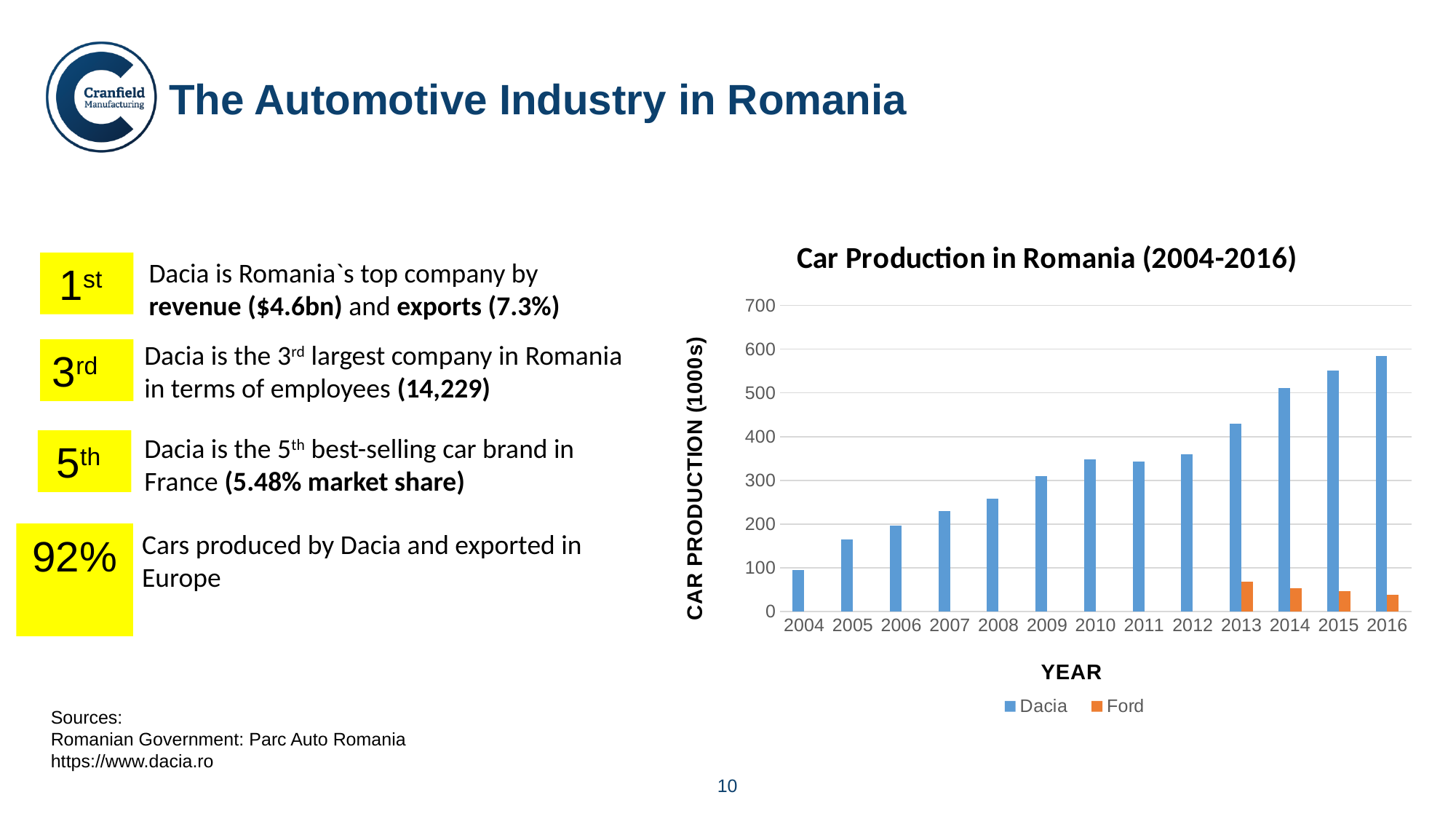
In which year is Ford's car production highest? 2013 Is the value for Dacia in 2004 greater or less than 100? less What kind of chart is shown on the slide? Bar chart How many series does the legend of the chart list? 2 Is the value for Dacia in 2016 greater or less than 500? greater Which series has the larger value in 2014, Dacia or Ford? Dacia In which year is Dacia's car production highest? 2016 In which year is Dacia's car production lowest? 2004 Is the value for Dacia in 2008 greater or less than 300? less Does Dacia's car production generally rise or fall from 2004 to 2016? Rise How many years are shown on the x axis of the chart? 13 What is the title of the chart? Car Production in Romania (2004-2016)